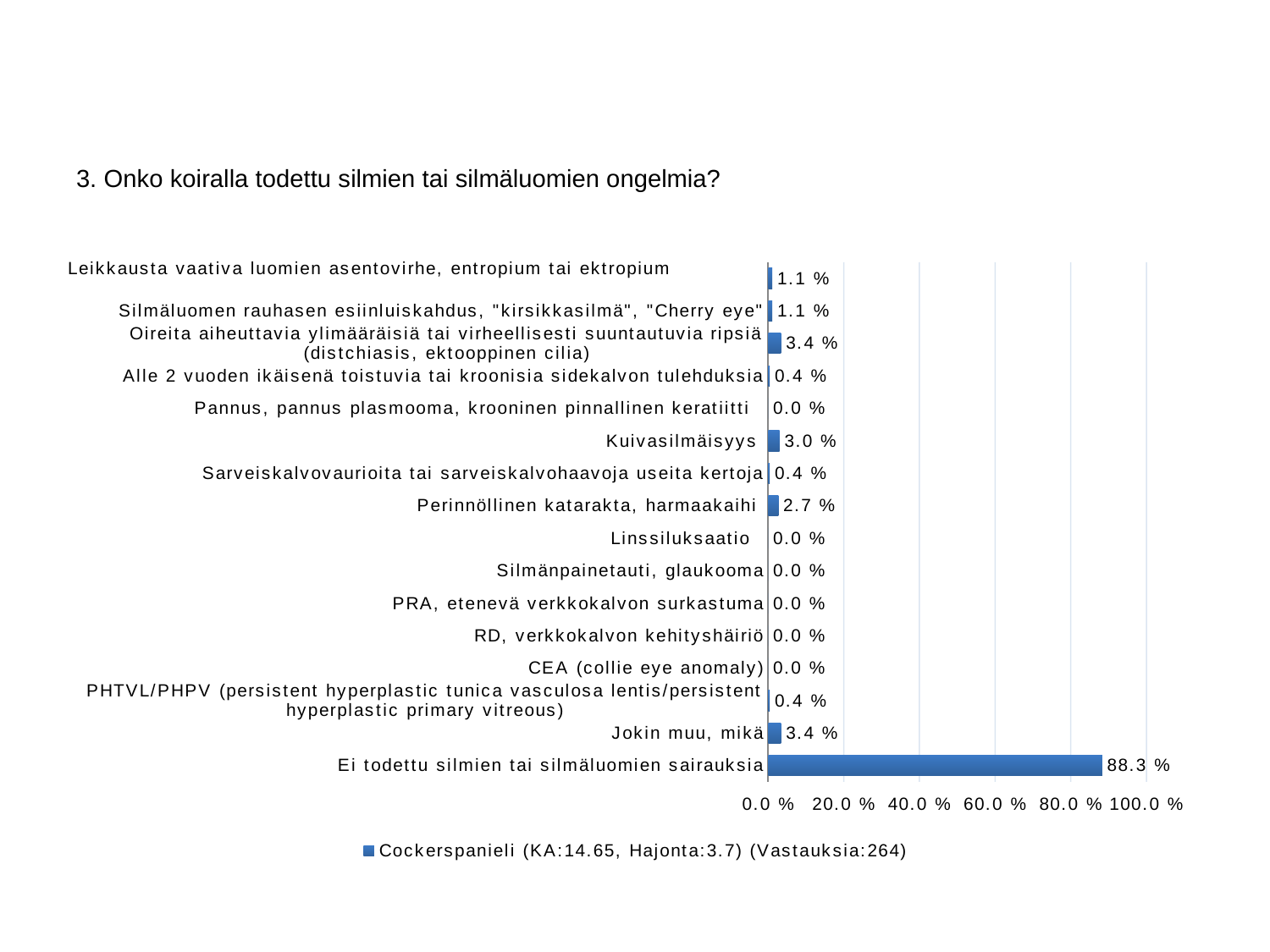
Which is larger, the value for "Kuivasilmäisyys" or the value for "Perinnöllinen katarakta, harmaakaihi"? Kuivasilmäisyys What is the difference between the values for "Kuivasilmäisyys" and "Perinnöllinen katarakta, harmaakaihi"? 0.3 % What is the value for "Jokin muu, mikä"? 3.4 % How many series does the legend list? 1 What is the value for "Perinnöllinen katarakta, harmaakaihi"? 2.7 % How many categories are shown in the chart? 16 What is the value for "Kuivasilmäisyys"? 3.0 % What is the difference between the values for "Ei todettu silmien tai silmäluomien sairauksia" and "Jokin muu, mikä"? 84.9 % What is the value for "Ei todettu silmien tai silmäluomien sairauksia"? 88.3 % Which category has the highest value? Ei todettu silmien tai silmäluomien sairauksia Is the value for "Ei todettu silmien tai silmäluomien sairauksia" greater or less than 80.0 %? greater What kind of chart is shown on the slide? Bar chart